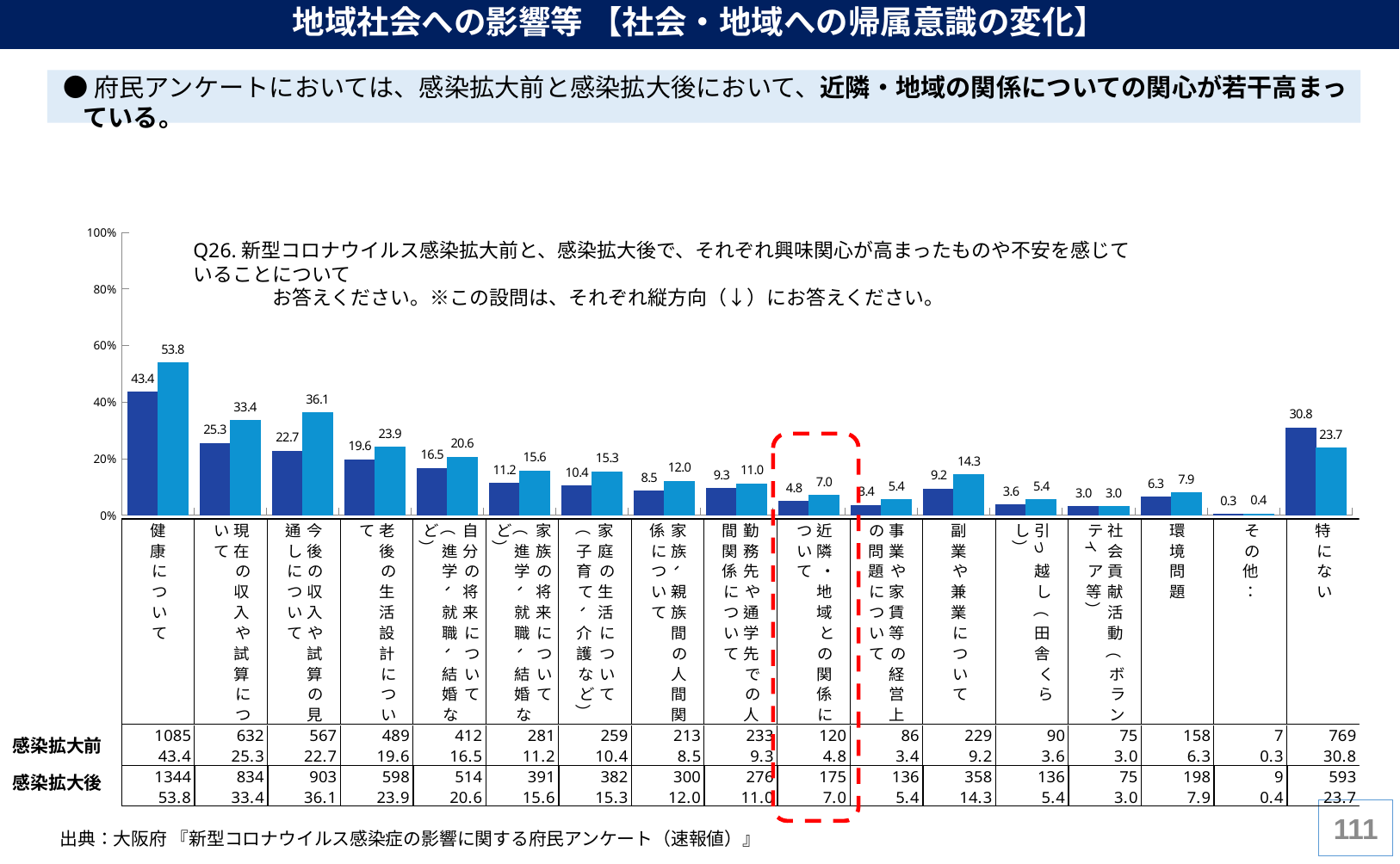
What kind of chart is shown on the slide? bar chart Which category has the lowest 感染拡大前 value? その他 Is the 感染拡大後 value for 現在の収入や試算について greater or less than 20%? greater How many series does the chart show (感染拡大前 and 感染拡大後)? 2 Which category is highlighted with a red dashed box on the chart? 近隣・地域との関係について What is the difference between the 感染拡大後 and 感染拡大前 values for 今後の収入や試算の見通しについて? 13.4 Which category has the highest 感染拡大後 value? 健康について What is the 感染拡大後 value for 副業や兼業について? 14.3 How many categories are plotted along the x axis of the chart? 17 What is the 感染拡大後 value for 健康について? 53.8 Which is larger for 特にない: the 感染拡大前 value or the 感染拡大後 value? 感染拡大前 What is the 感染拡大前 value for 近隣・地域との関係について? 4.8